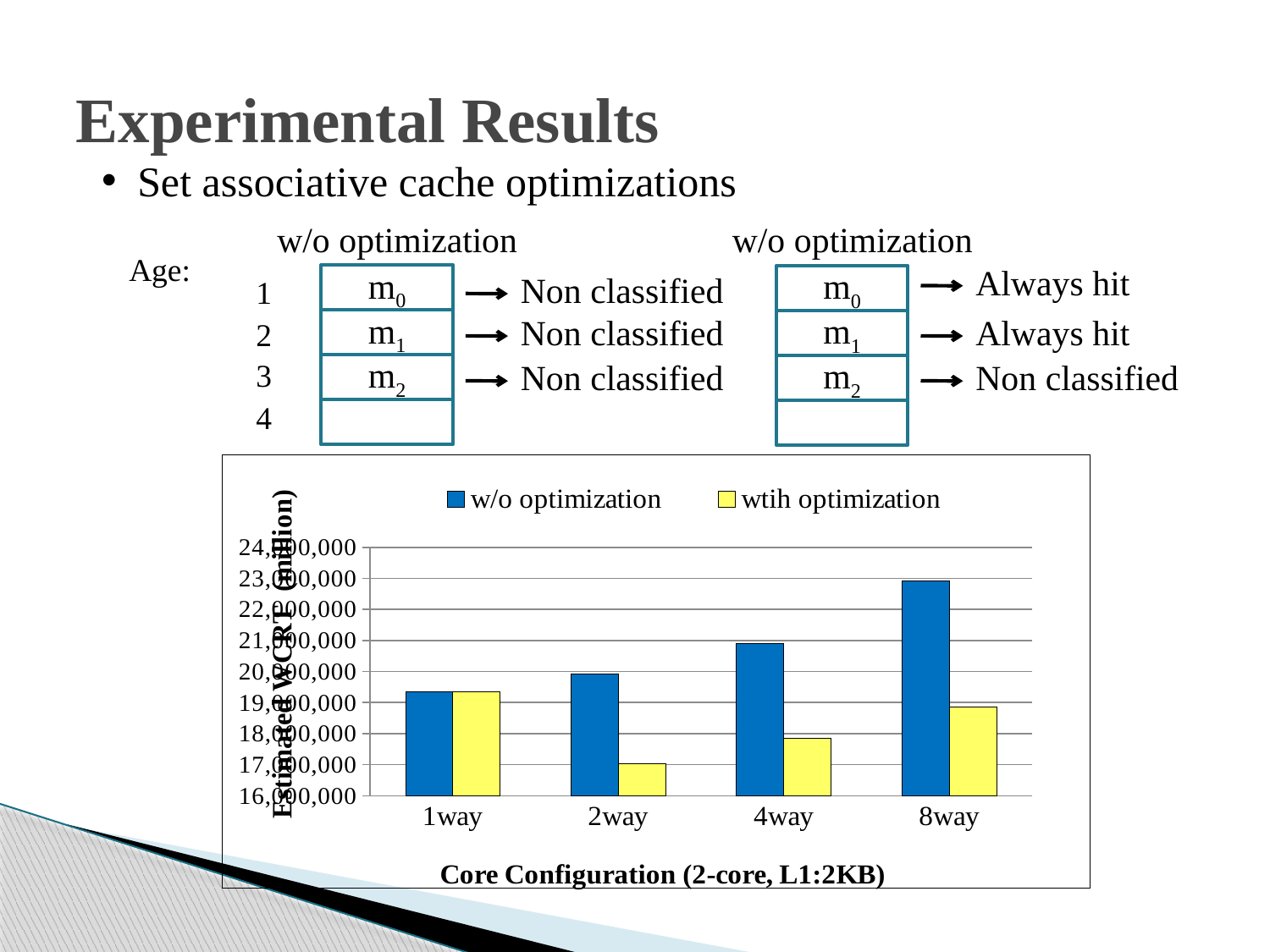
What is the title of the chart's x axis? Core Configuration (2-core, L1:2KB) Is the w/o optimization value for 8way greater or less than 22,000,000? greater Which core configuration has the lowest wtih optimization value? 2way Is the w/o optimization value for 4way greater or less than 20,000,000? greater How many series does the chart's legend list? 2 Do the w/o optimization values rise or fall from 1way to 8way? rise How many core configuration categories are shown on the x axis of the chart? 4 Is the wtih optimization value for 2way greater or less than 18,000,000? less At 8way, which series has the larger value, w/o optimization or wtih optimization? w/o optimization What kind of chart is shown on the slide? bar chart Which core configuration has the highest w/o optimization value? 8way